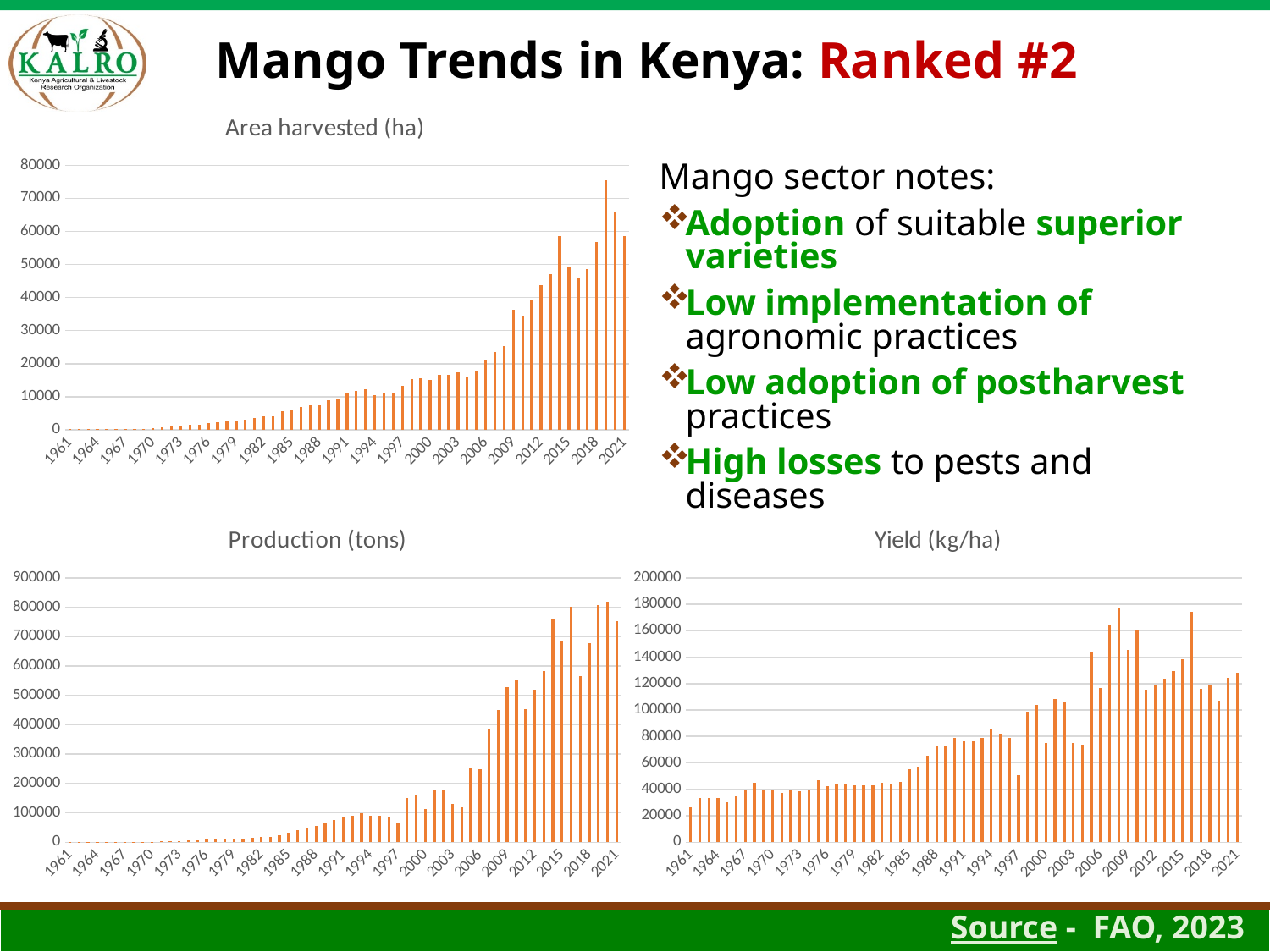
In the 'Production (tons)' chart, which year has the larger value, 1991 or 2021? 2021 In the 'Yield (kg/ha)' chart, is the value for 1961 greater or less than 40000? less In the 'Production (tons)' chart, is the value for 2021 greater or less than 500000? greater In the 'Area harvested (ha)' chart, do the values generally rise or fall from 1961 to 2021? rise In the 'Area harvested (ha)' chart, is the value for 2021 greater or less than 40000? greater What is the title of the chart in the top-left of the slide? Area harvested (ha) What is the highest value shown on the vertical axis of the 'Production (tons)' chart? 900000 What kind of chart is the 'Area harvested (ha)' chart? bar chart In the 'Yield (kg/ha)' chart, which year has the larger value, 1970 or 2006? 2006